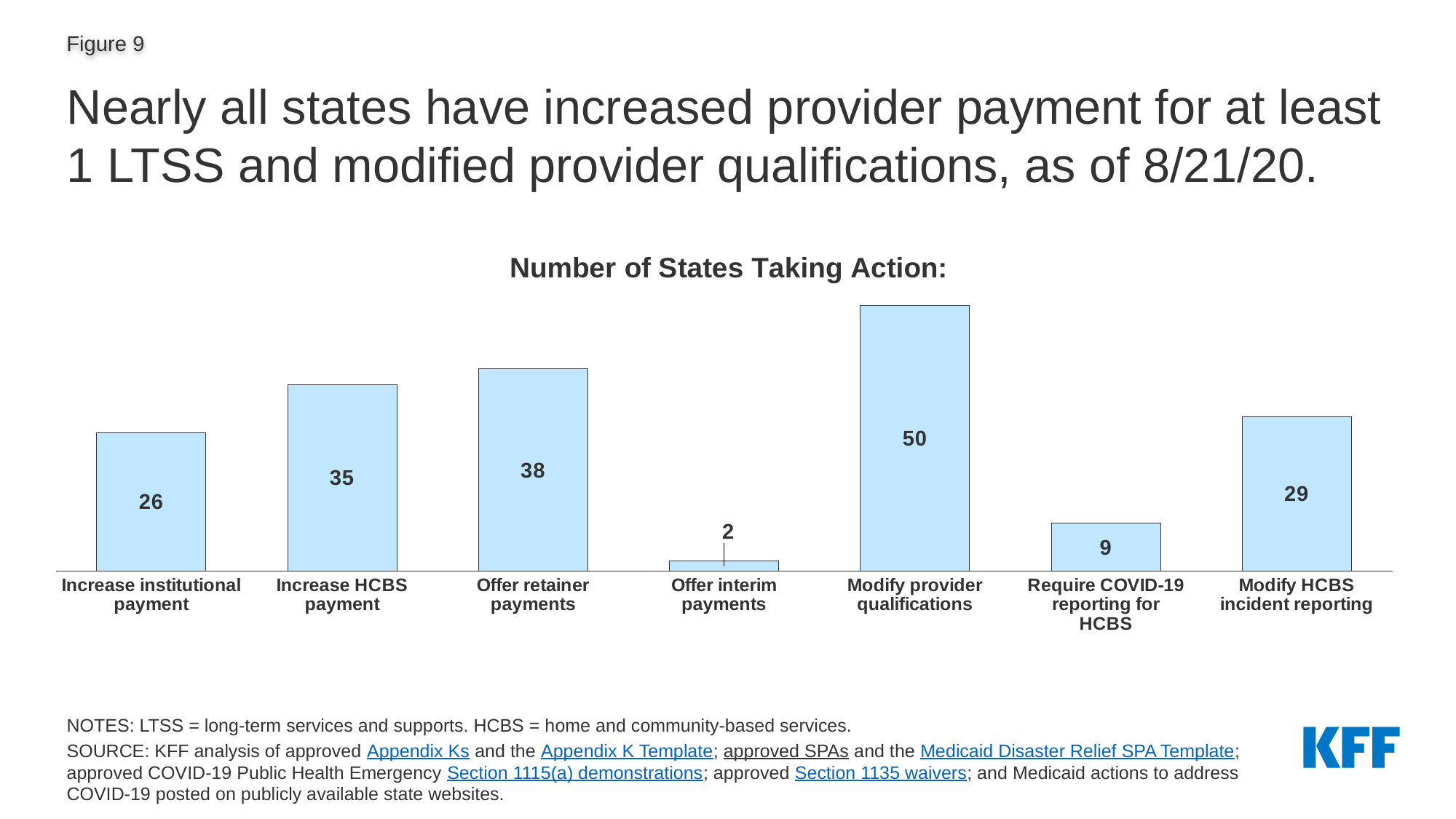
How many states have taken action to increase institutional payment? 26 Which action has been taken by the fewest states? Offer interim payments How many action categories are shown in the chart? 7 What is the number of states that offer retainer payments? 38 What is the difference between the number of states modifying HCBS incident reporting and the number requiring COVID-19 reporting for HCBS? 20 What is the title of the chart? Number of States Taking Action: Which action has been taken by the most states? Modify provider qualifications What is the total number of states shown for offering retainer payments and offering interim payments combined? 40 How many states require COVID-19 reporting for HCBS? 9 Which has more states taking action: increasing HCBS payment or increasing institutional payment? Increase HCBS payment What type of chart is shown on the slide? Bar chart How many more states modified provider qualifications than increased HCBS payment? 15